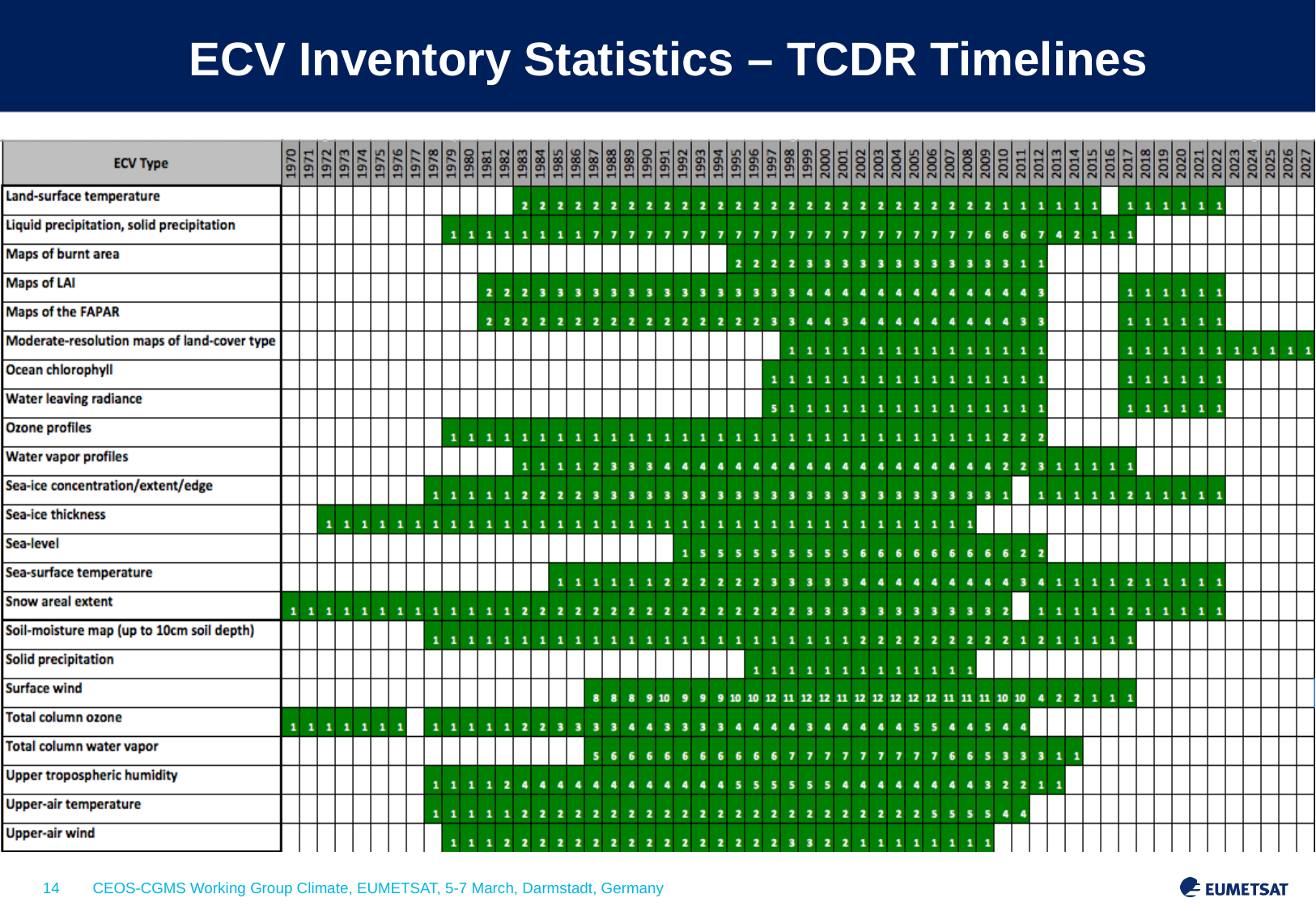
Which two ECV types have timelines that begin in 1970? Snow areal extent and Total column ozone What is the first year shown on the horizontal axis of the timeline? 1970 Is the highest value in the Surface wind row greater or less than 10? greater Which ECV type's timeline extends furthest to the right, reaching 2027? Moderate-resolution maps of land-cover type In which year does the Sea-ice thickness timeline begin? 1972 What kind of chart is shown on the slide? A timeline table (heatmap grid of ECV types by year) How many ECV types are listed as rows in the timeline? 23 Which ECV type row contains the highest count value in the grid? Surface wind What is the last year shown on the horizontal axis of the timeline? 2027 What is the title of the chart on the slide? ECV Inventory Statistics – TCDR Timelines What is the highest count value shown in the Sea-level row? 6 What is the highest count value shown in the Surface wind row? 12